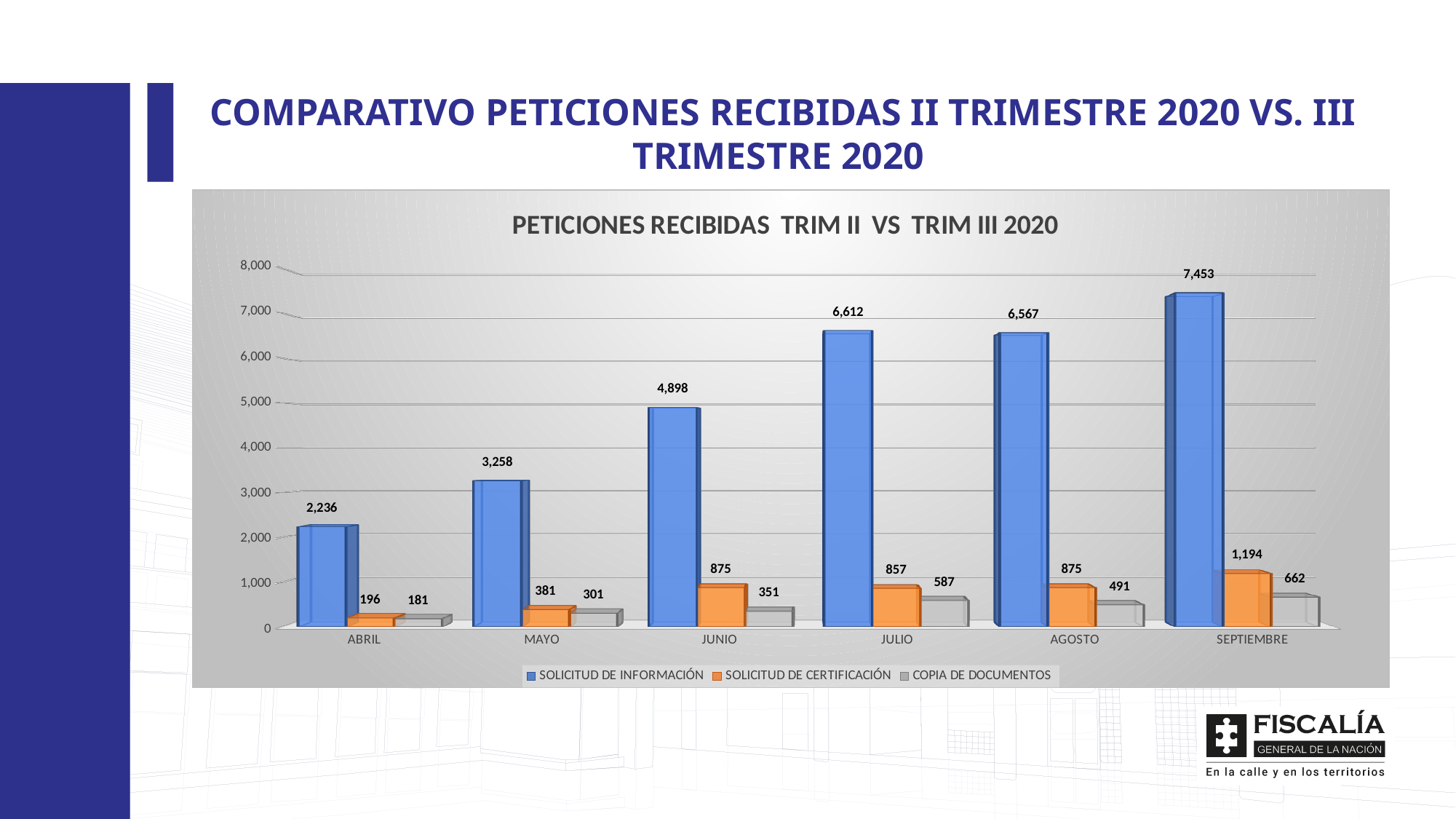
What is the difference between SOLICITUD DE INFORMACIÓN in JULIO and in AGOSTO? 45 Which month has the highest value for SOLICITUD DE INFORMACIÓN? SEPTIEMBRE Which month has the lowest value for COPIA DE DOCUMENTOS? ABRIL Is the value of SOLICITUD DE INFORMACIÓN for JUNIO greater or less than 5,000? less How many series does the legend list? 3 How many months are shown on the x axis? 6 What kind of chart is shown? Bar chart Which is larger: COPIA DE DOCUMENTOS in JULIO or in AGOSTO? JULIO What is the value of SOLICITUD DE CERTIFICACIÓN for JUNIO? 875 What is the value of SOLICITUD DE INFORMACIÓN for SEPTIEMBRE? 7,453 What is the value of COPIA DE DOCUMENTOS for ABRIL? 181 What is the title of the chart? PETICIONES RECIBIDAS TRIM II VS TRIM III 2020